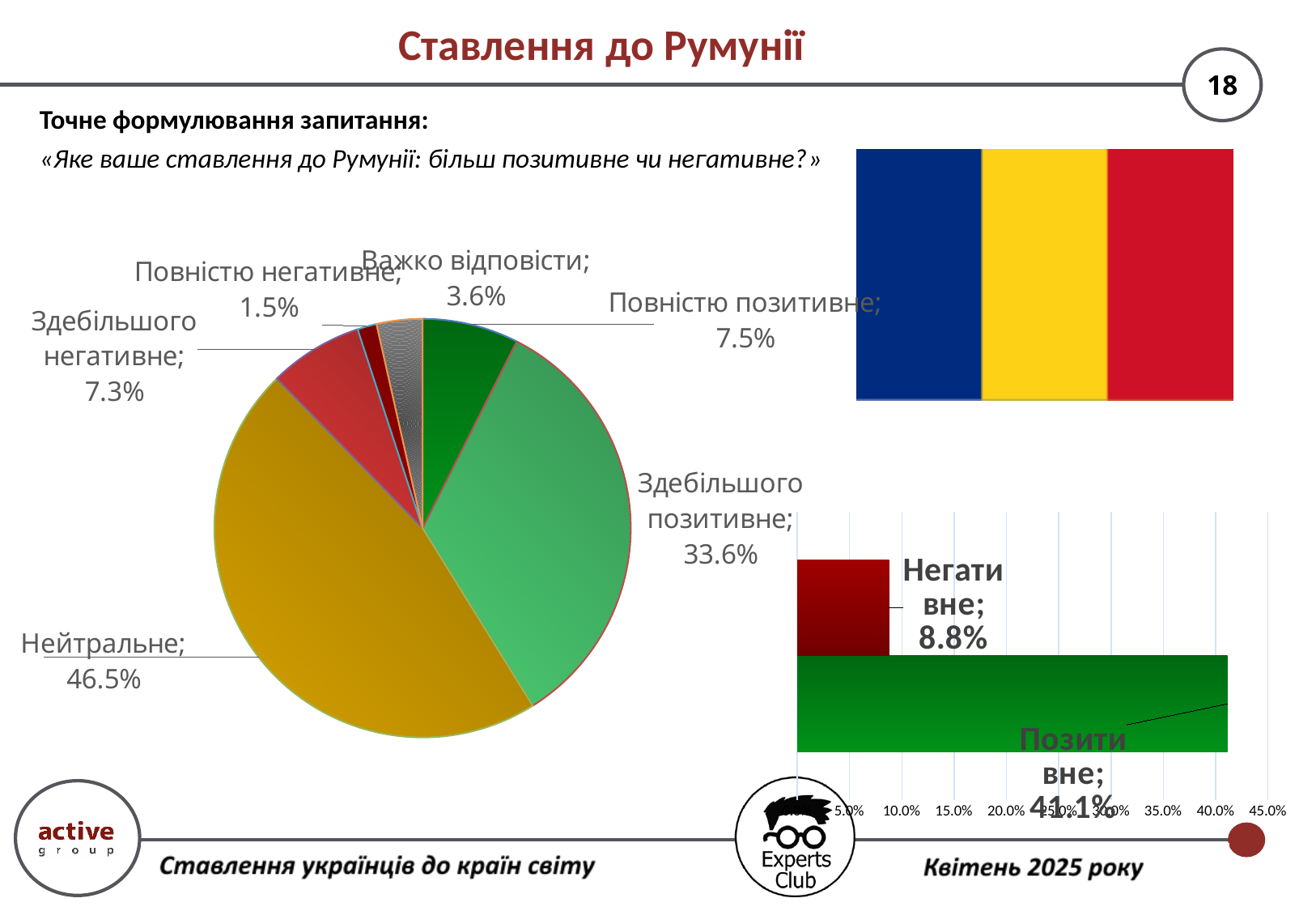
In the pie chart, what is the value for Нейтральне? 46.5% In the pie chart, how many slices are there? 6 In the bar chart on the right, what is the difference between Позитивне and Негативне? 32.3% In the pie chart, which category has the largest share? Нейтральне In the bar chart on the right, what is the value for Позитивне? 41.1% What type of chart is shown on the right side of the slide below the flag? Bar chart In the pie chart, which category has the smallest share? Повністю негативне In the bar chart on the right, what is the value for Негативне? 8.8% In the pie chart, what is the difference between Здебільшого позитивне and Здебільшого негативне? 26.3% In the pie chart, what is the value for Повністю негативне? 1.5% In the pie chart, which is larger: Повністю позитивне or Важко відповісти? Повністю позитивне In the pie chart, what is the value for Здебільшого позитивне? 33.6%